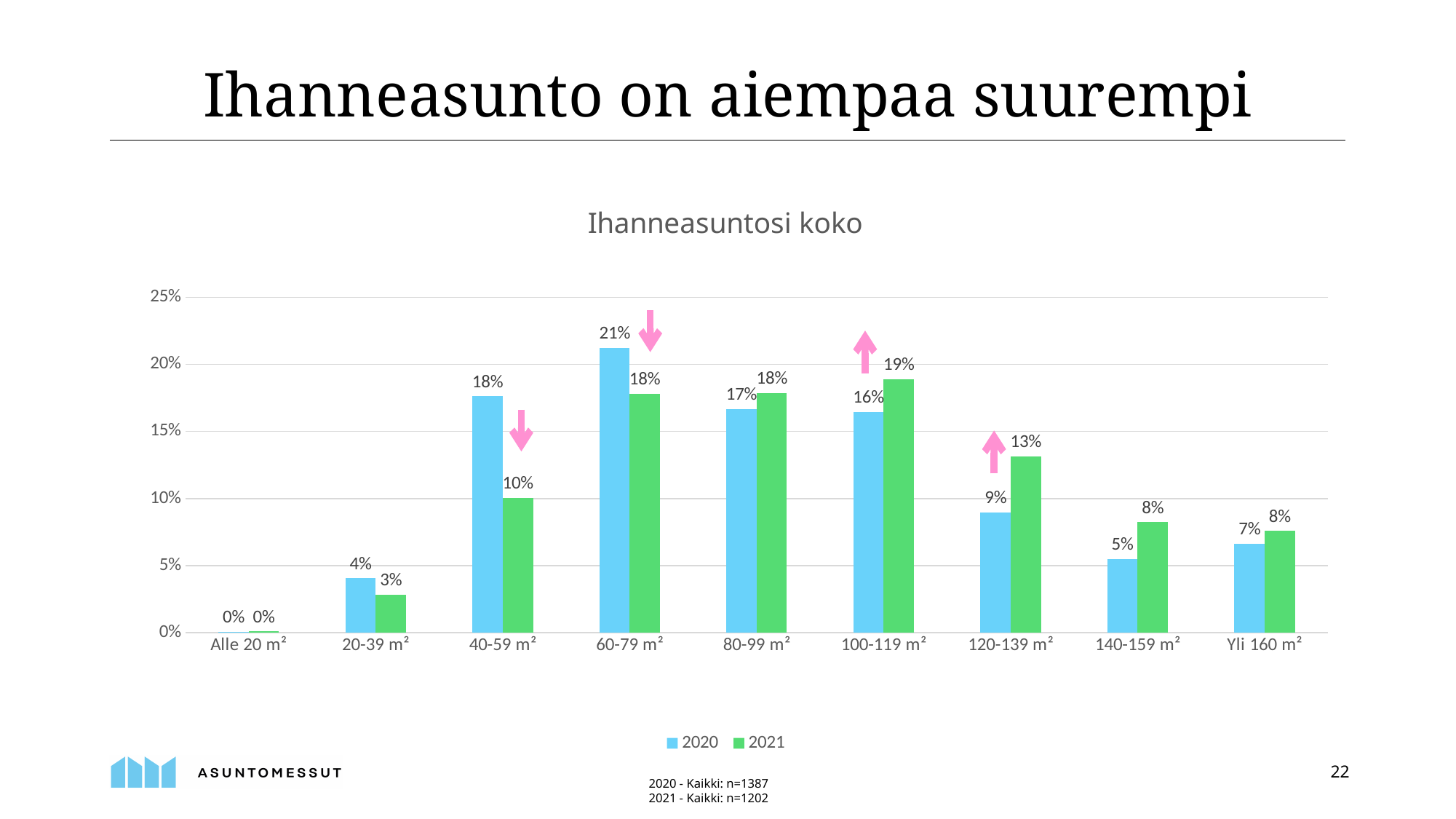
Which is larger for 100-119 m², the 2020 value or the 2021 value? 2021 What is the 2021 value for 120-139 m²? 13% Is the 2020 value for 140-159 m² greater or less than 10%? less How many size categories are shown on the x axis? 9 What is the 2021 value for 40-59 m²? 10% Which category has the highest 2021 value? 100-119 m² What is the title of the chart? Ihanneasuntosi koko What is the difference between the 2020 and 2021 values for 40-59 m²? 8% How many series does the legend list? 2 Which category has the highest 2020 value? 60-79 m² What is the 2020 value for 60-79 m²? 21% What kind of chart is shown? bar chart